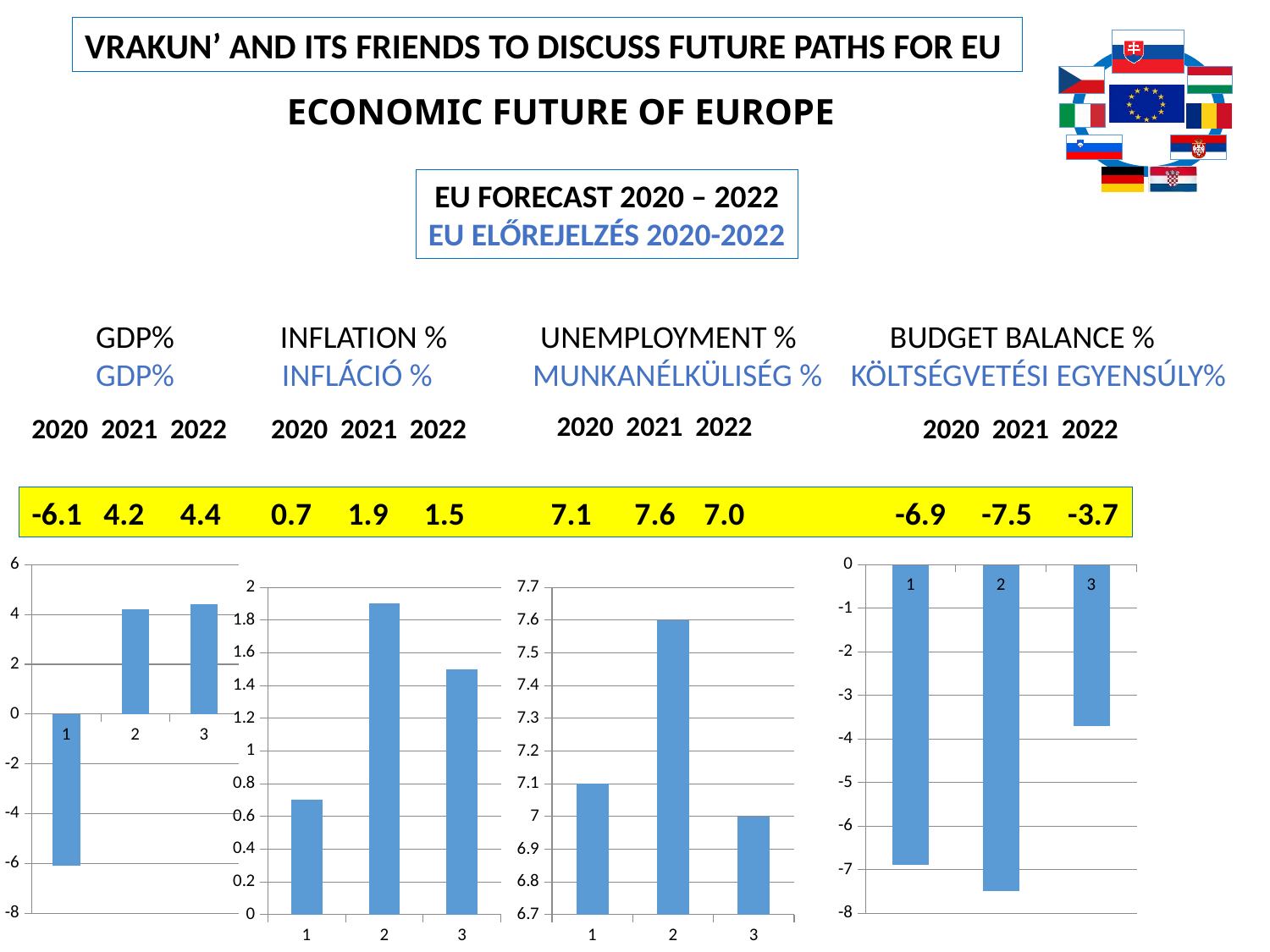
In the Budget Balance % chart (rightmost), what is the value for 2021 (category 2)? -7.5 How many bar charts are on the slide? 4 In the Inflation % chart (second from left), what is the value for 2021 (category 2)? 1.9 In the GDP% chart (leftmost), what is the value for 2020 (category 1)? -6.1 In the Unemployment % chart (third from left), what is the value for 2022 (category 3)? 7.0 What kind of chart is used for the GDP% data? bar chart In the Budget Balance % chart (rightmost), is the value for 2022 greater or less than -4? greater In the Inflation % chart (second from left), which year has the lowest value? 2020 In the Unemployment % chart (third from left), which is larger, the value for 2020 or the value for 2021? 2021 In the GDP% chart (leftmost), which year has the highest value? 2022 How many bars does each chart on the slide contain? 3 In the Inflation % chart (second from left), what is the difference between the 2021 and 2022 values? 0.4